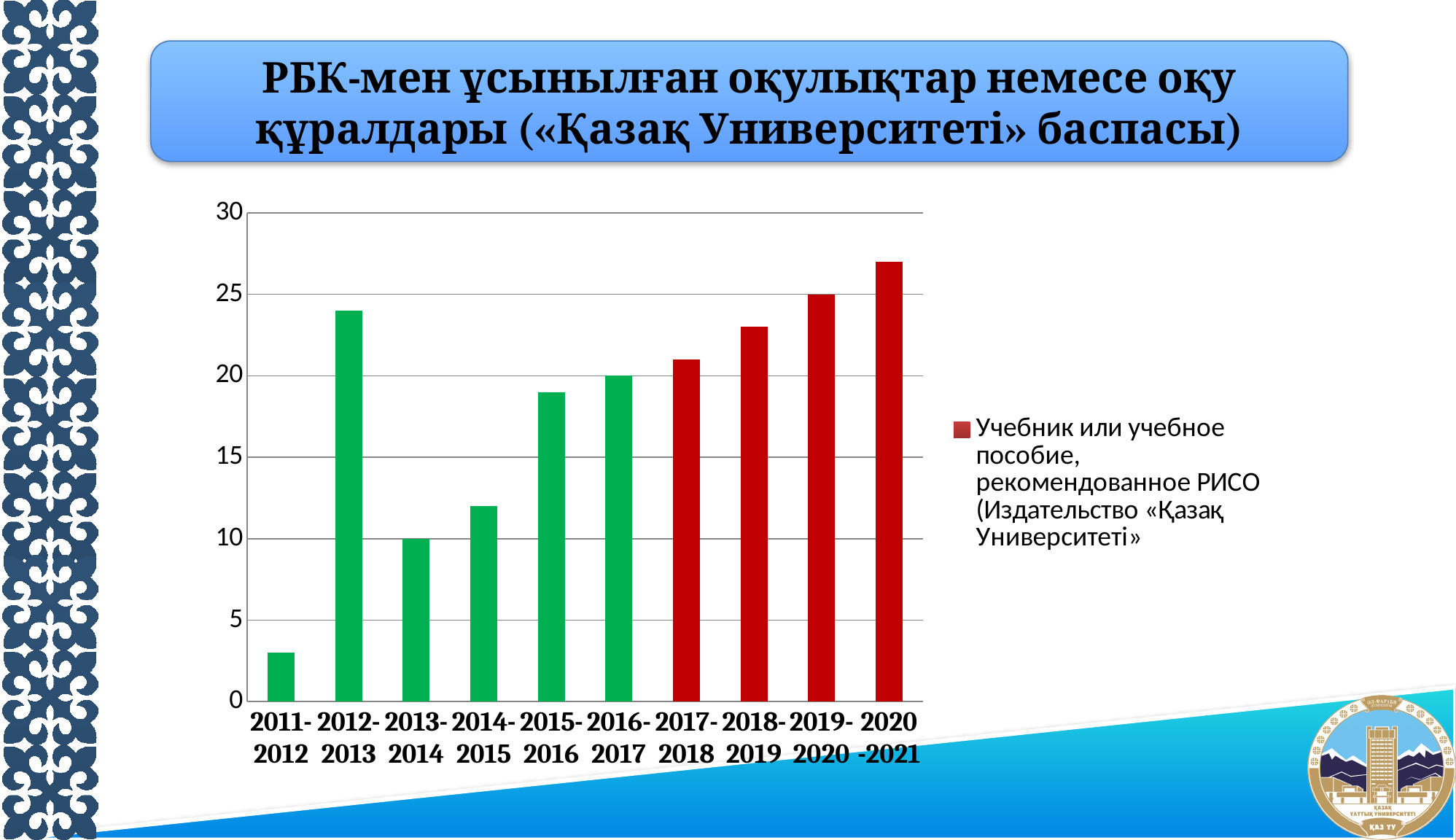
What is the value for 2013-2014? 10 Which is larger, the value for 2014-2015 or the value for 2015-2016? 2015-2016 What is the value for 2019-2020? 25 Is the value for 2011-2012 greater or less than 5? less What is the value for 2016-2017? 20 How many series does the legend list? 1 Is the value for 2020-2021 greater or less than 25? greater Which academic year has the highest bar? 2020-2021 What kind of chart is shown on the slide? bar chart Which academic year has the lowest bar? 2011-2012 From 2013-2014 to 2020-2021, do the values rise or fall along the x axis? rise How many academic-year categories are shown on the x axis? 10